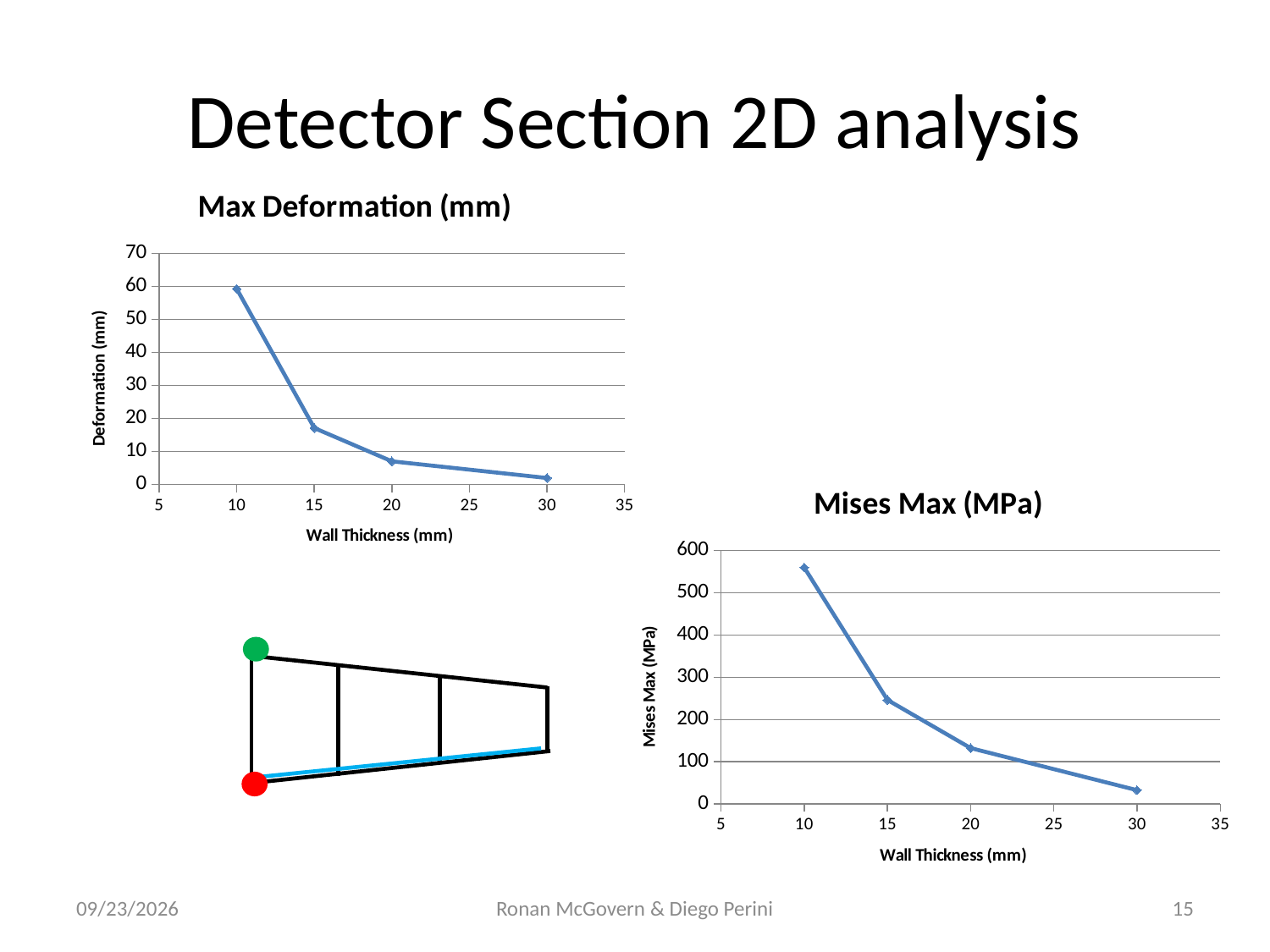
In the Max Deformation (mm) chart, do the values rise or fall as wall thickness increases? fall What is the x-axis title of the Mises Max (MPa) chart? Wall Thickness (mm) In the Mises Max (MPa) chart, is the value at a wall thickness of 10 mm greater or less than 500? greater In the Max Deformation (mm) chart, which is larger, the deformation at 15 mm or at 20 mm? 15 mm In the Mises Max (MPa) chart, is the value at a wall thickness of 15 mm greater or less than 300? less What kind of chart is the Mises Max (MPa) chart? line chart How many data points are plotted in the Max Deformation (mm) chart? 4 In the Max Deformation (mm) chart, is the deformation at a wall thickness of 10 mm greater or less than 50? greater In the Max Deformation (mm) chart, which wall thickness has the highest deformation? 10 In the Mises Max (MPa) chart, which wall thickness has the lowest Mises Max value? 30 What kind of chart is the Max Deformation (mm) chart? line chart